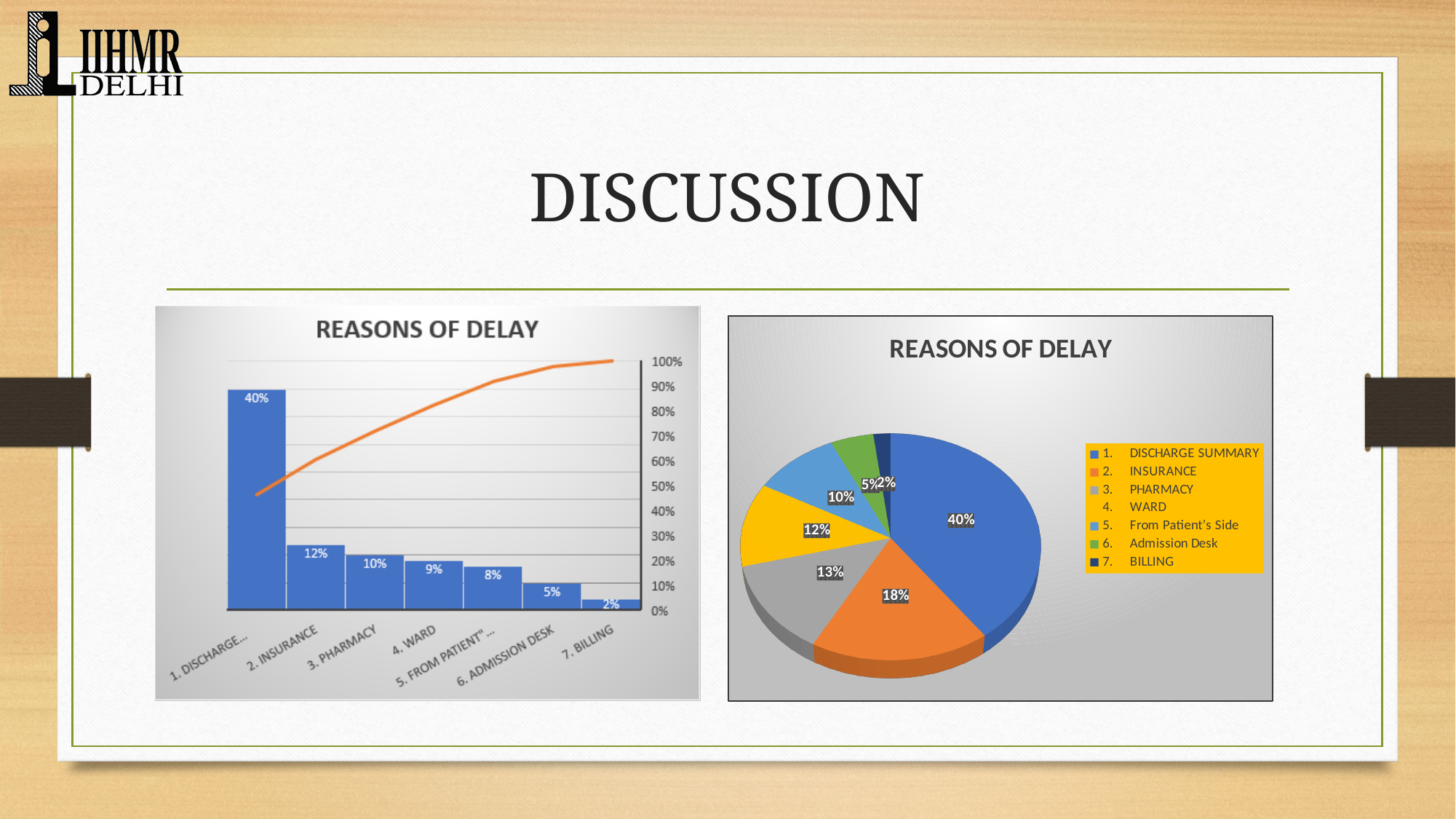
In the bar chart on the left, which category has the lowest value? 7. BILLING In the pie chart on the right, which category has the largest slice? DISCHARGE SUMMARY In the bar chart on the left, how many bars are plotted? 7 In the bar chart on the left, what is the value for 2. INSURANCE? 12% What kind of chart is shown on the right side of the slide? pie chart In the pie chart on the right, what is the value for PHARMACY? 13% In the bar chart on the left, what is the difference between the values for 3. PHARMACY and 4. WARD? 1% In the bar chart on the left, what is the value for 6. ADMISSION DESK? 5% In the pie chart on the right, how many entries does the legend list? 7 In the pie chart on the right, which is larger, WARD or From Patient's Side? WARD In the pie chart on the right, what share does INSURANCE have? 18% In the bar chart on the left, do the bar values rise or fall from left to right along the x axis? fall